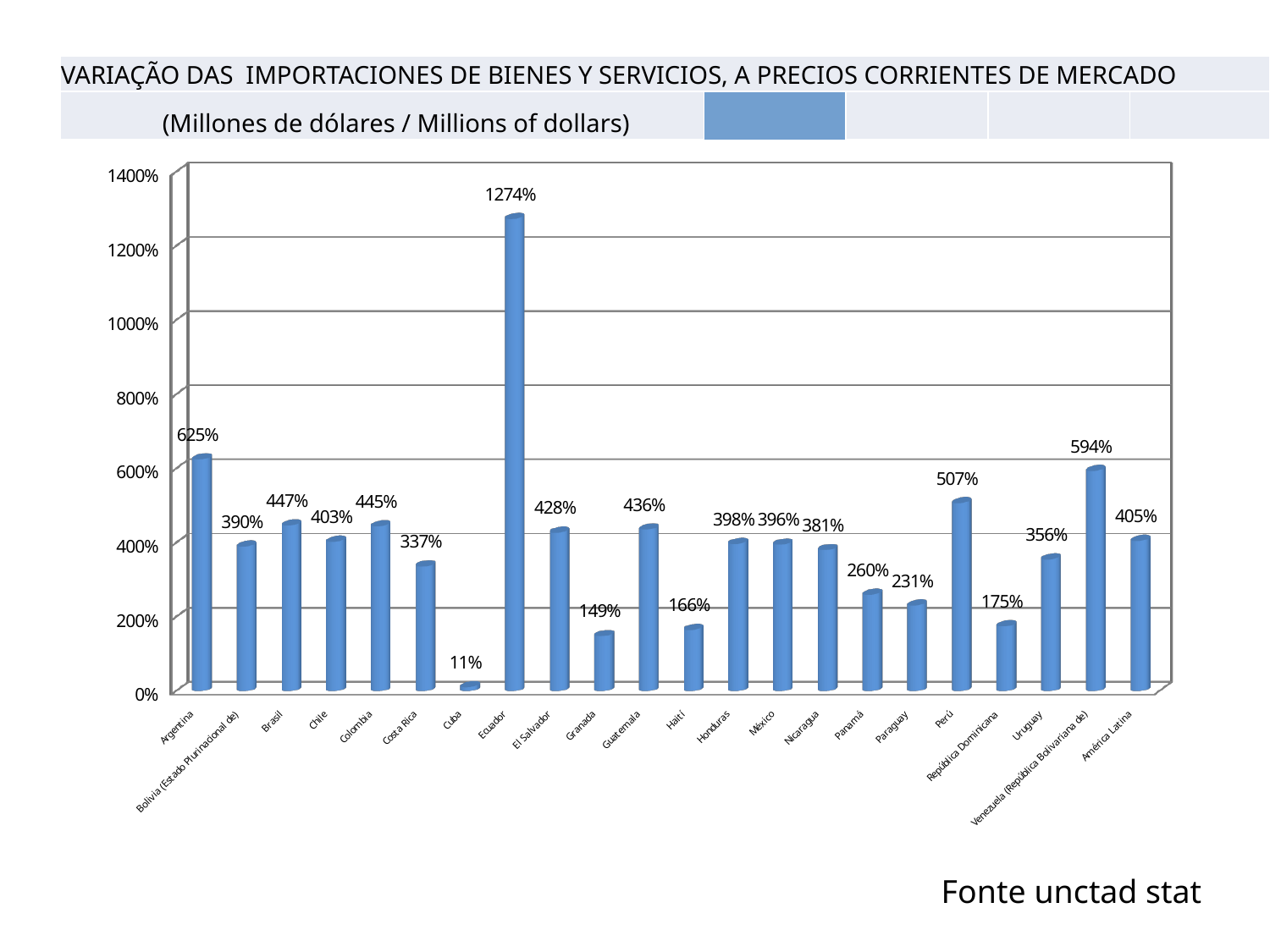
What kind of chart is shown on the slide? Bar chart What is the value for Ecuador? 1274% Which is larger, the value for Perú or the value for Venezuela (República Bolivariana de)? Venezuela (República Bolivariana de) Which category has the highest value? Ecuador What is the value for Perú? 507% What is the difference between the values for Venezuela (República Bolivariana de) and Uruguay? 238% Which category has the lowest value? Cuba How many categories are shown on the x axis? 22 What is the difference between the values for Ecuador and Argentina? 649% What is the value for América Latina? 405% What source is cited below the chart? Fonte unctad stat What is the value for Haití? 166%